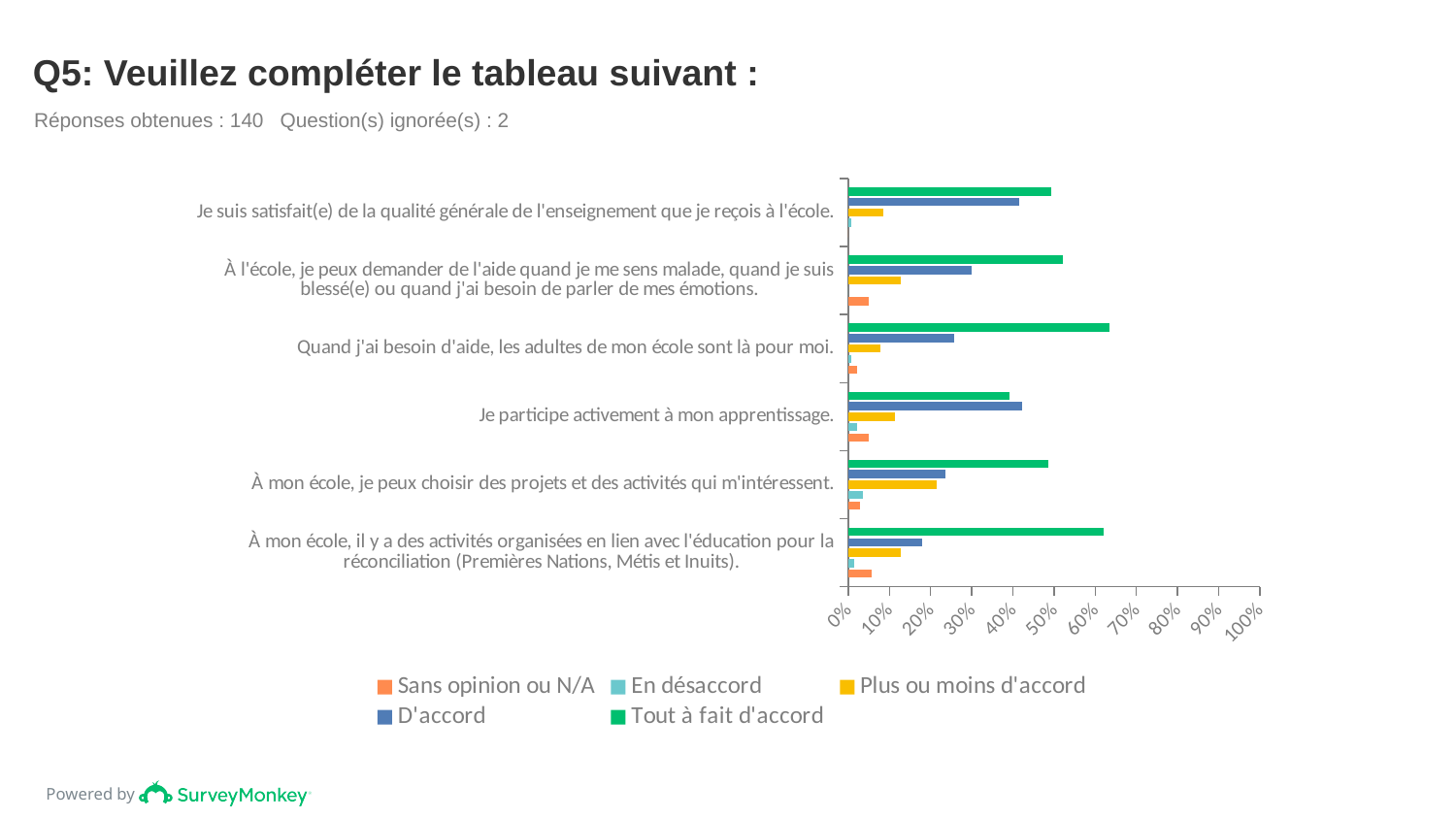
How many series does the chart legend list? 5 What colour represents 'Tout à fait d'accord' in the legend? Green Is the 'Tout à fait d'accord' value for 'Quand j'ai besoin d'aide, les adultes de mon école sont là pour moi.' greater or less than 60%? greater Is the 'Plus ou moins d'accord' value for 'À mon école, je peux choisir des projets et des activités qui m'intéressent.' greater or less than 10%? greater Which statement has the lowest value for 'Tout à fait d'accord'? Je participe activement à mon apprentissage. For 'À l'école, je peux demander de l'aide quand je me sens malade, quand je suis blessé(e) ou quand j'ai besoin de parler de mes émotions.', which is larger: 'Tout à fait d'accord' or 'D'accord'? Tout à fait d'accord How many statements (categories) are plotted on the chart? 6 Is the 'D'accord' value for 'À l'école, je peux demander de l'aide quand je me sens malade, quand je suis blessé(e) ou quand j'ai besoin de parler de mes émotions.' greater or less than 20%? greater Which statement has the lowest value for 'D'accord'? À mon école, il y a des activités organisées en lien avec l'éducation pour la réconciliation (Premières Nations, Métis et Inuits). What kind of chart is shown on the slide? Bar chart For 'À mon école, il y a des activités organisées en lien avec l'éducation pour la réconciliation (Premières Nations, Métis et Inuits).', which is larger: 'D'accord' or 'Plus ou moins d'accord'? D'accord